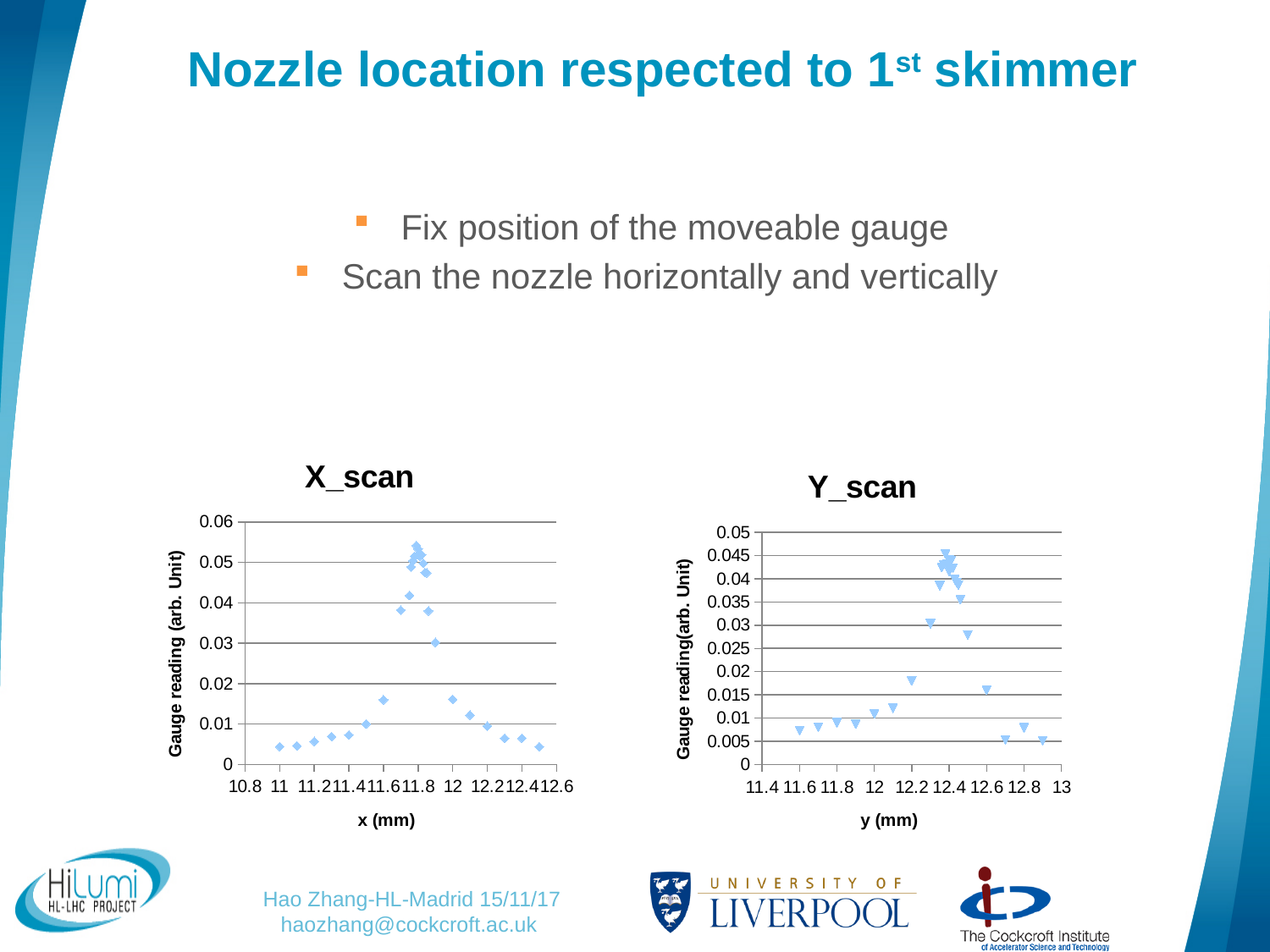
What kind of chart is the Y_scan chart? scatter chart In the X_scan chart, is the highest gauge reading greater or less than 0.04? greater In the X_scan chart, is the gauge reading at x = 12 mm greater or less than 0.01? greater In the Y_scan chart, is the gauge reading at y = 11.6 mm greater or less than 0.01? less What kind of chart is the X_scan chart? scatter chart In the Y_scan chart, which has the larger gauge reading: y = 11.6 mm or y = 12.6 mm? y = 12.6 mm In the X_scan chart, which has the larger gauge reading: x = 11 mm or x = 12 mm? x = 12 mm What is the x-axis label of the Y_scan chart? y (mm) What is the title of the chart on the left of the slide? X_scan